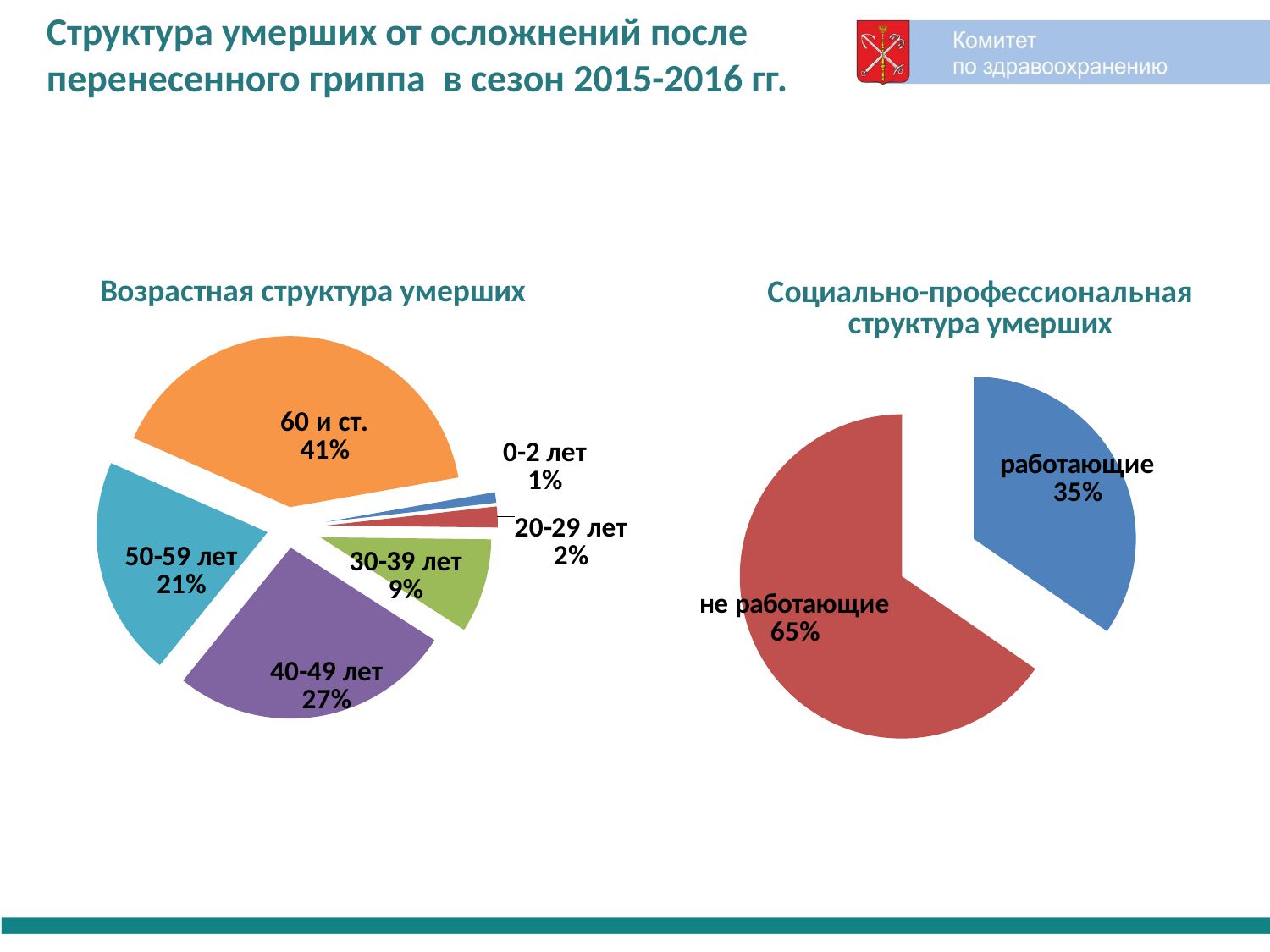
What type of chart is the chart titled "Социально-профессиональная структура умерших"? Pie chart In the chart titled "Возрастная структура умерших", what colour is the "60 и ст." slice? Orange In the chart titled "Социально-профессиональная структура умерших", what is the difference in percentage points between "не работающие" and "работающие"? 30 In the chart titled "Возрастная структура умерших", which age category has the largest share? 60 и ст. In the chart titled "Возрастная структура умерших", what share of deaths is in the "40-49 лет" category? 27% In the chart titled "Социально-профессиональная структура умерших", what share of deaths is in the "не работающие" category? 65% In the chart titled "Возрастная структура умерших", which share is larger: "40-49 лет" or "50-59 лет"? 40-49 лет In the chart titled "Социально-профессиональная структура умерших", what share of deaths is in the "работающие" category? 35% In the chart titled "Возрастная структура умерших", what is the difference in percentage points between the "50-59 лет" and "30-39 лет" shares? 12 In the chart titled "Возрастная структура умерших", which age category has the smallest share? 0-2 лет In the chart titled "Возрастная структура умерших", what share of deaths is in the "60 и ст." category? 41% In the chart titled "Возрастная структура умерших", how many age categories are shown? 6